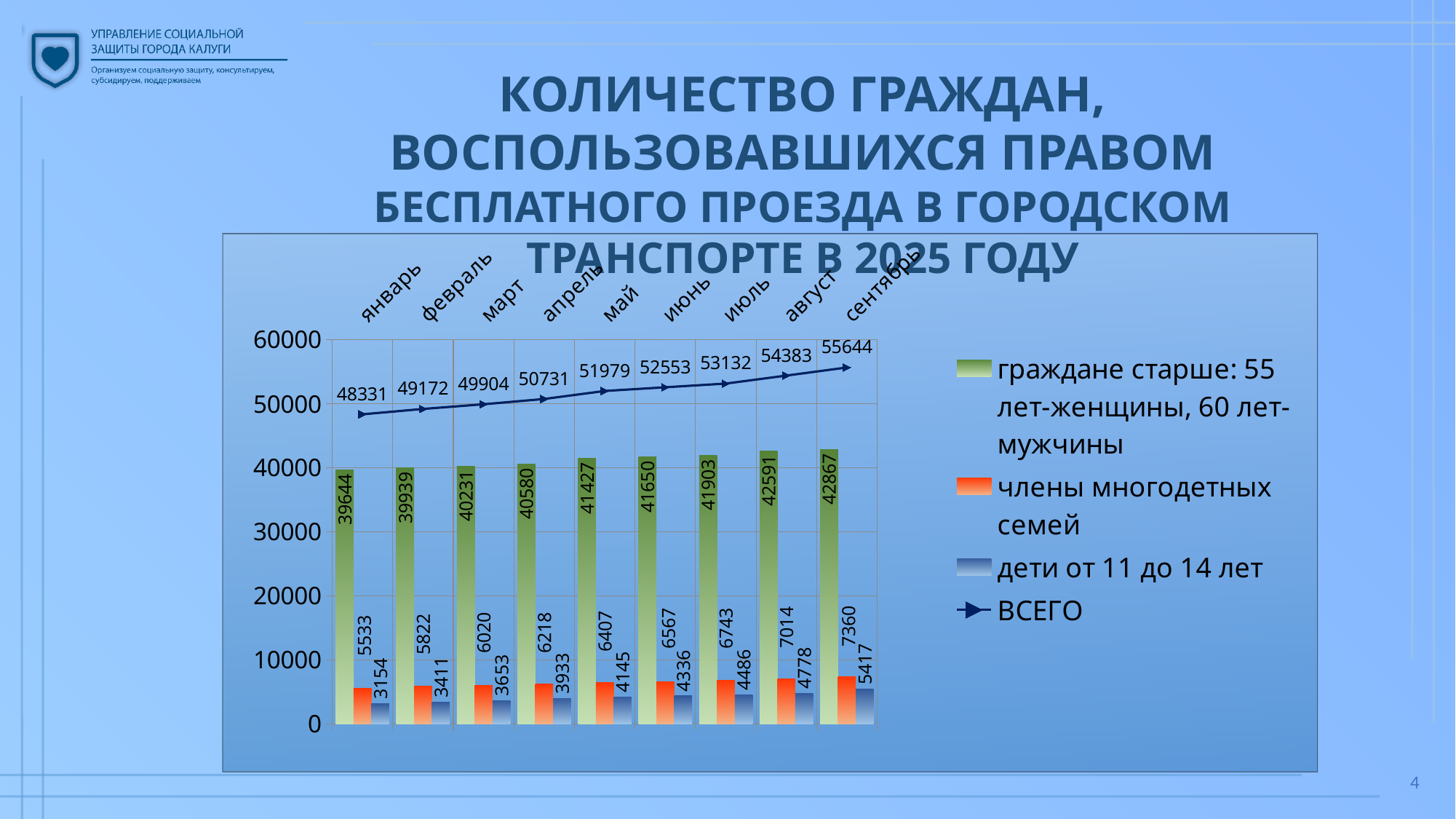
What kind of chart is shown on the slide? bar chart with a line What is the difference between the ВСЕГО values for сентябрь and январь? 7313 Does the ВСЕГО line rise or fall from январь to сентябрь? rises What is the value for граждане старше 55 лет-женщины, 60 лет-мужчины in август? 42591 How many series does the legend list? 4 What is the value for дети от 11 до 14 лет in январь? 3154 What is the value of ВСЕГО for сентябрь? 55644 Which is larger: the value for дети от 11 до 14 лет in сентябрь or the value for члены многодетных семей in январь? члены многодетных семей in январь In which month is the value for члены многодетных семей the highest? сентябрь In which month is the ВСЕГО value the lowest? январь How many months are shown on the x axis? 9 How many members of large families (члены многодетных семей) used free transport in май? 6407